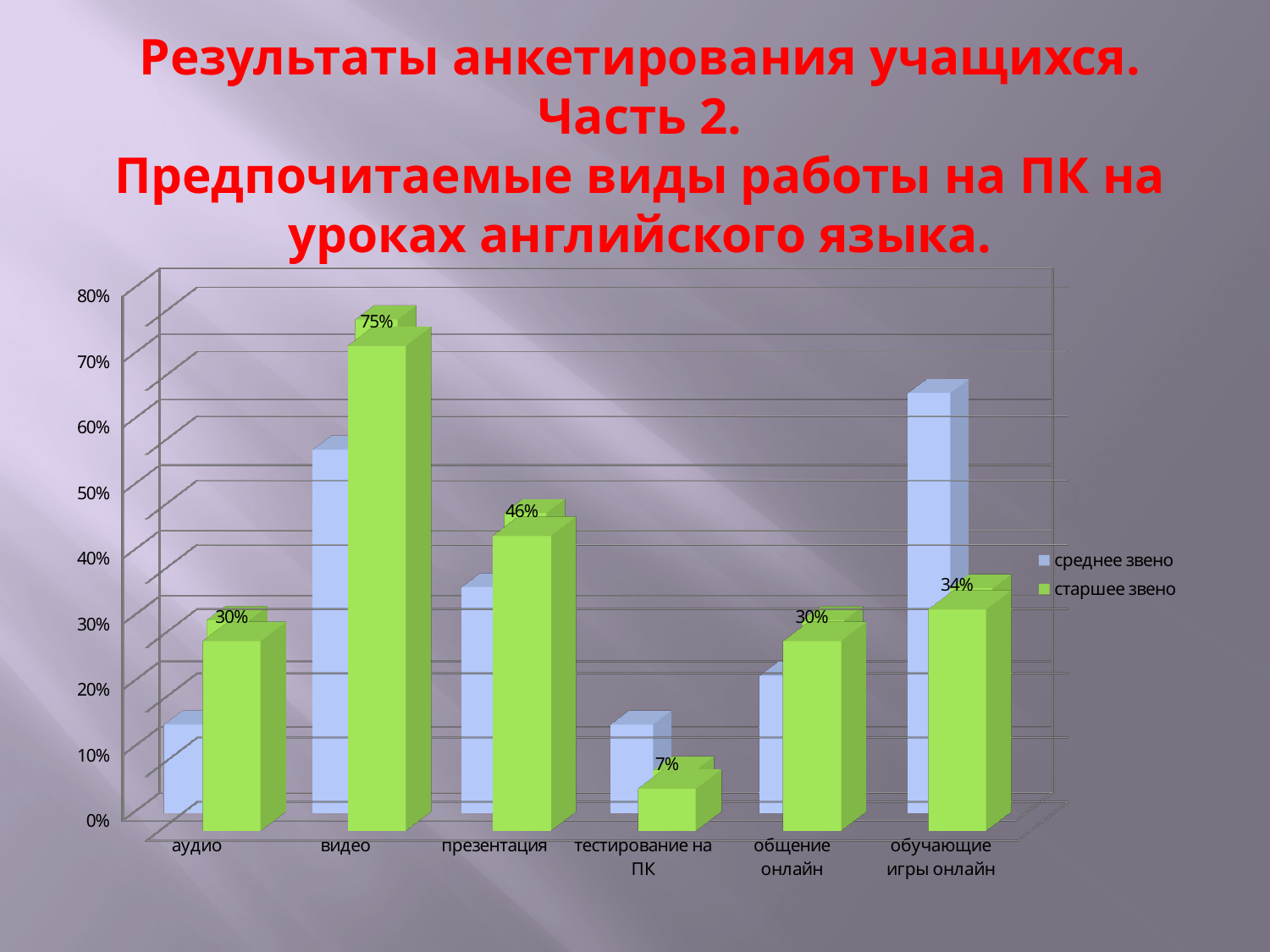
What is the value for старшее звено in the тестирование на ПК category? 7% Which series has the larger value in the обучающие игры онлайн category, среднее звено or старшее звено? среднее звено How many series does the legend list? 2 What is the difference between the старшее звено values for видео and тестирование на ПК? 68 percentage points What is the value for старшее звено in the видео category? 75% Is the value for среднее звено in the обучающие игры онлайн category greater or less than 60%? greater What is the value for старшее звено in the обучающие игры онлайн category? 34% How many categories are shown on the x axis of the chart? 6 Is the value for среднее звено in the аудио category greater or less than 20%? less Which category has the highest value for старшее звено? видео What is the value for старшее звено in the презентация category? 46% Which category has the lowest value for старшее звено? тестирование на ПК